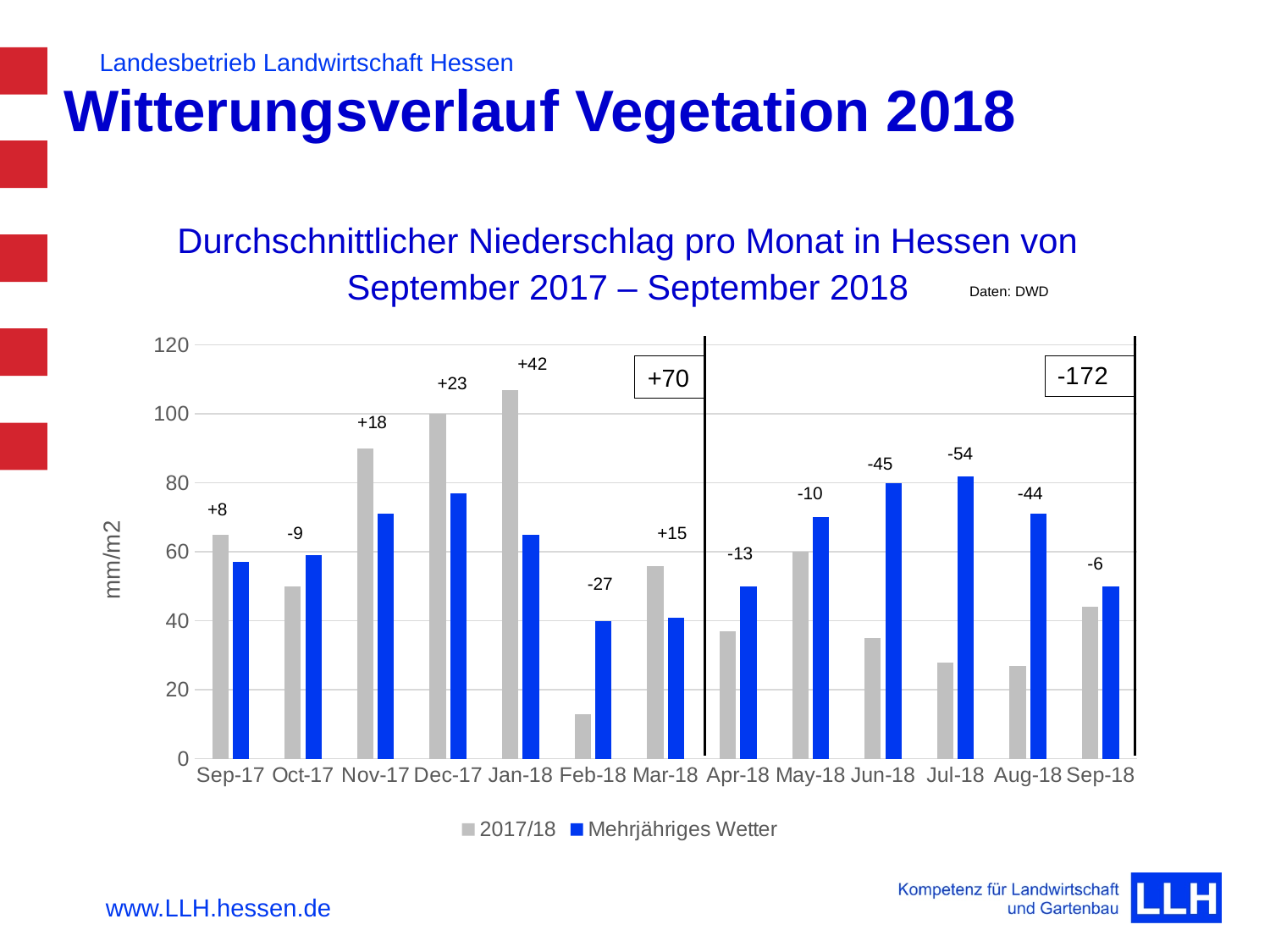
What is the label on the y axis? mm/m2 What kind of chart is shown on the slide? bar chart What difference value is labelled above the bars for Feb-18? -27 Is the 2017/18 value for Feb-18 greater or less than 20? less For Jul-18, which is larger: the 2017/18 bar or the Mehrjähriges Wetter bar? Mehrjähriges Wetter Is the 2017/18 value for Jan-18 greater or less than 100? greater How many months are shown on the x axis? 13 Which month has the highest 2017/18 bar? Jan-18 What difference value is labelled above the bars for Jan-18? +42 How many series does the legend list? 2 Which month has the lowest 2017/18 bar? Feb-18 What difference value is labelled above the bars for Jul-18? -54